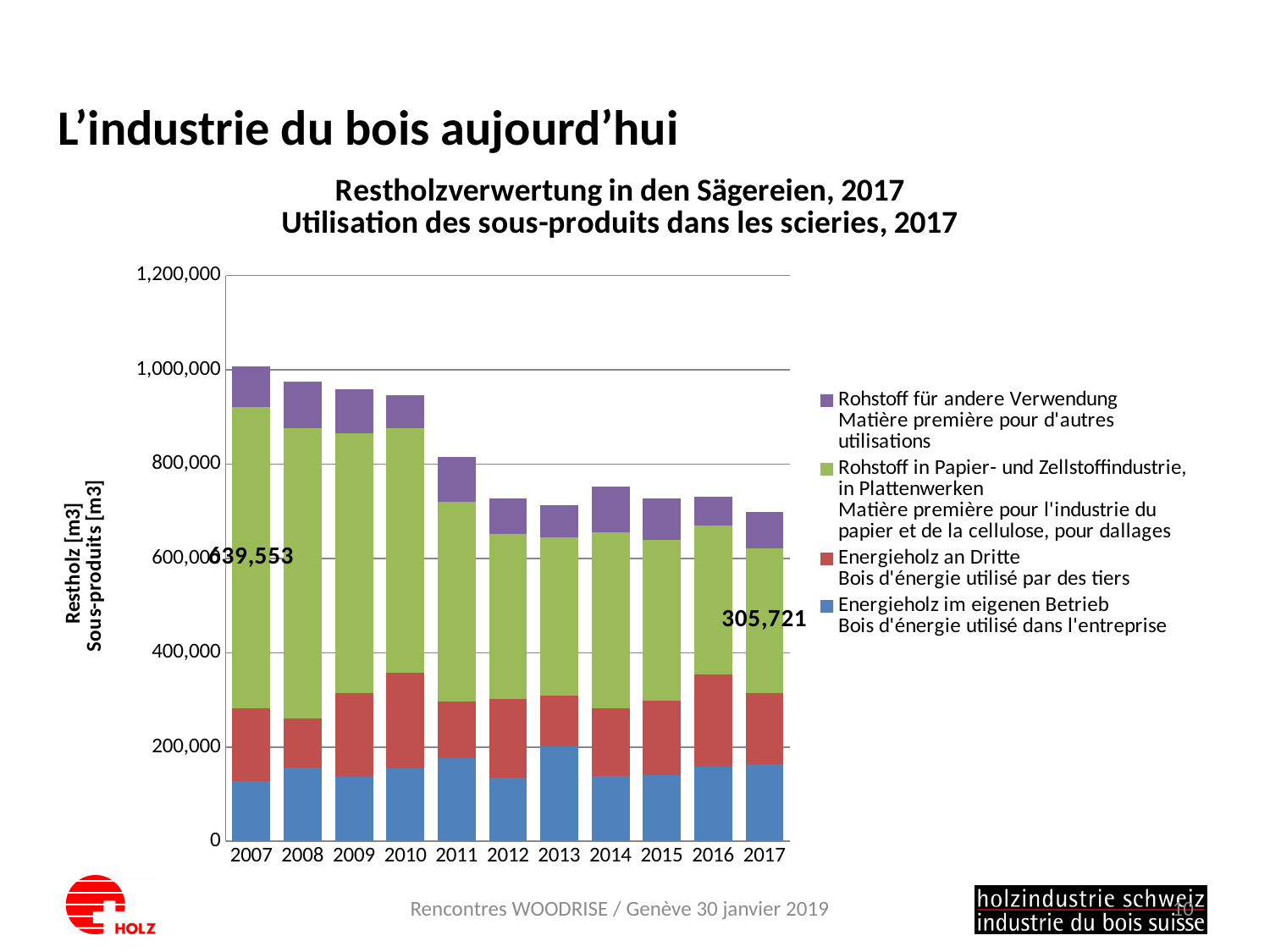
Which year has the highest total stacked bar? 2007 How many series does the legend list? 4 Is the Energieholz im eigenen Betrieb value for 2007 greater or less than 200,000? less Which year has the larger total stacked bar, 2007 or 2017? 2007 What is the labelled value for the Rohstoff in Papier- und Zellstoffindustrie series in 2017? 305,721 What kind of chart is shown on the slide? Stacked bar chart How many years are shown on the x axis of the chart? 11 Is the total stacked bar for 2012 greater or less than 800,000? less By how much did the labelled Rohstoff in Papier- und Zellstoffindustrie value fall from 2007 to 2017? 333,832 Do the total stacked bar heights generally rise or fall from 2007 to 2017? Fall Which colour represents Energieholz im eigenen Betrieb in the legend? Blue What is the labelled value for the Rohstoff in Papier- und Zellstoffindustrie series in 2007? 639,553